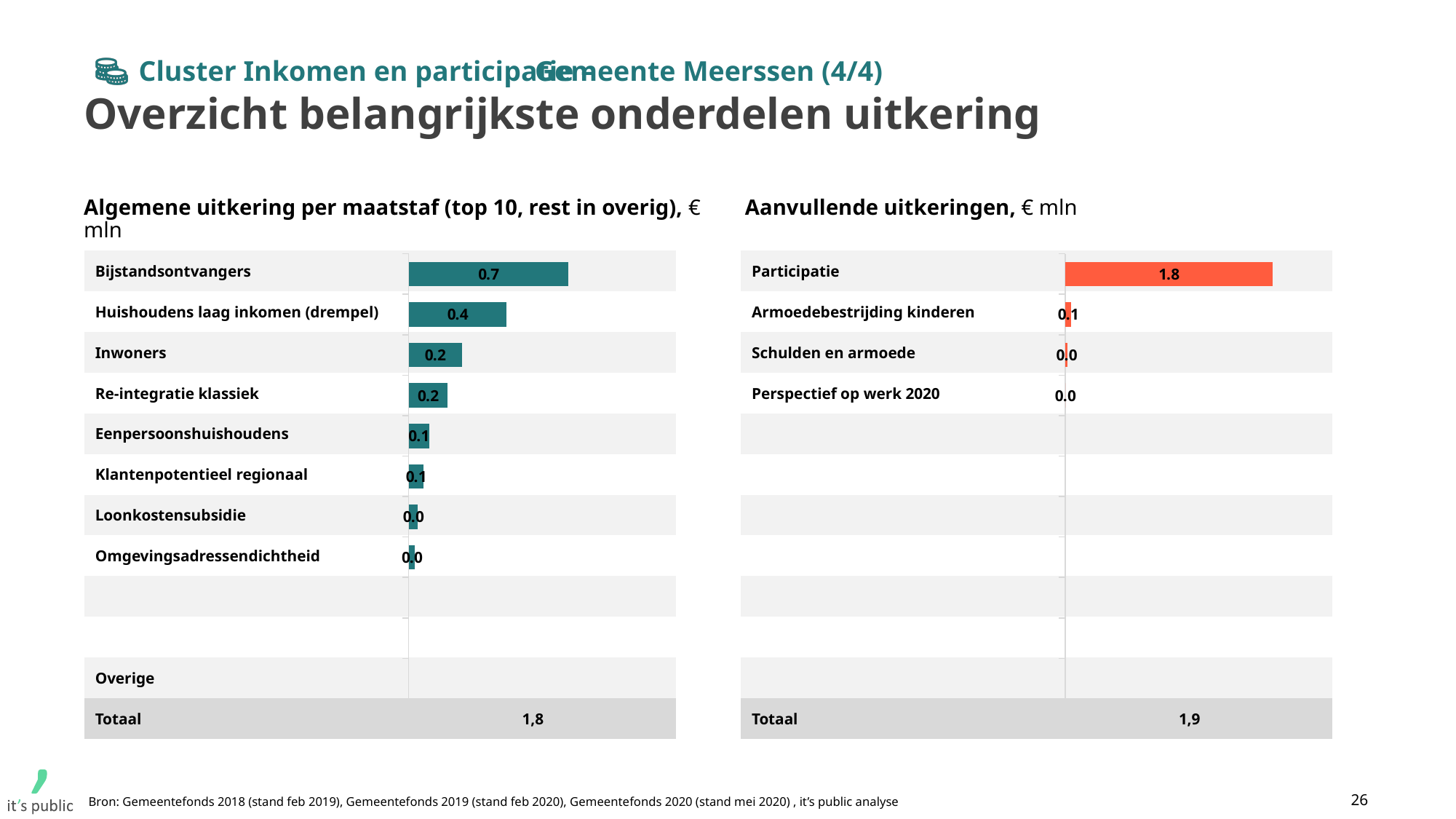
In the 'Algemene uitkering per maatstaf' chart, what is the value for Bijstandsontvangers? 0.7 In the 'Aanvullende uitkeringen' chart, what is the value for Participatie? 1.8 In the 'Algemene uitkering per maatstaf' chart, which category has the highest value? Bijstandsontvangers In the 'Algemene uitkering per maatstaf' chart, what is the difference between Bijstandsontvangers and Huishoudens laag inkomen (drempel)? 0.3 In the 'Aanvullende uitkeringen' chart, what is the Totaal value shown? 1,9 Which is larger: Participatie in the 'Aanvullende uitkeringen' chart or Bijstandsontvangers in the 'Algemene uitkering per maatstaf' chart? Participatie In the 'Aanvullende uitkeringen' chart, what is the value for Armoedebestrijding kinderen? 0.1 In the 'Algemene uitkering per maatstaf' chart, what is the Totaal value shown? 1,8 In the 'Algemene uitkering per maatstaf' chart, what is the value for Huishoudens laag inkomen (drempel)? 0.4 In the 'Aanvullende uitkeringen' chart, how many categories have a plotted value? 4 In the 'Aanvullende uitkeringen' chart, which category has the highest value? Participatie What kind of chart is the 'Aanvullende uitkeringen' chart? Bar chart